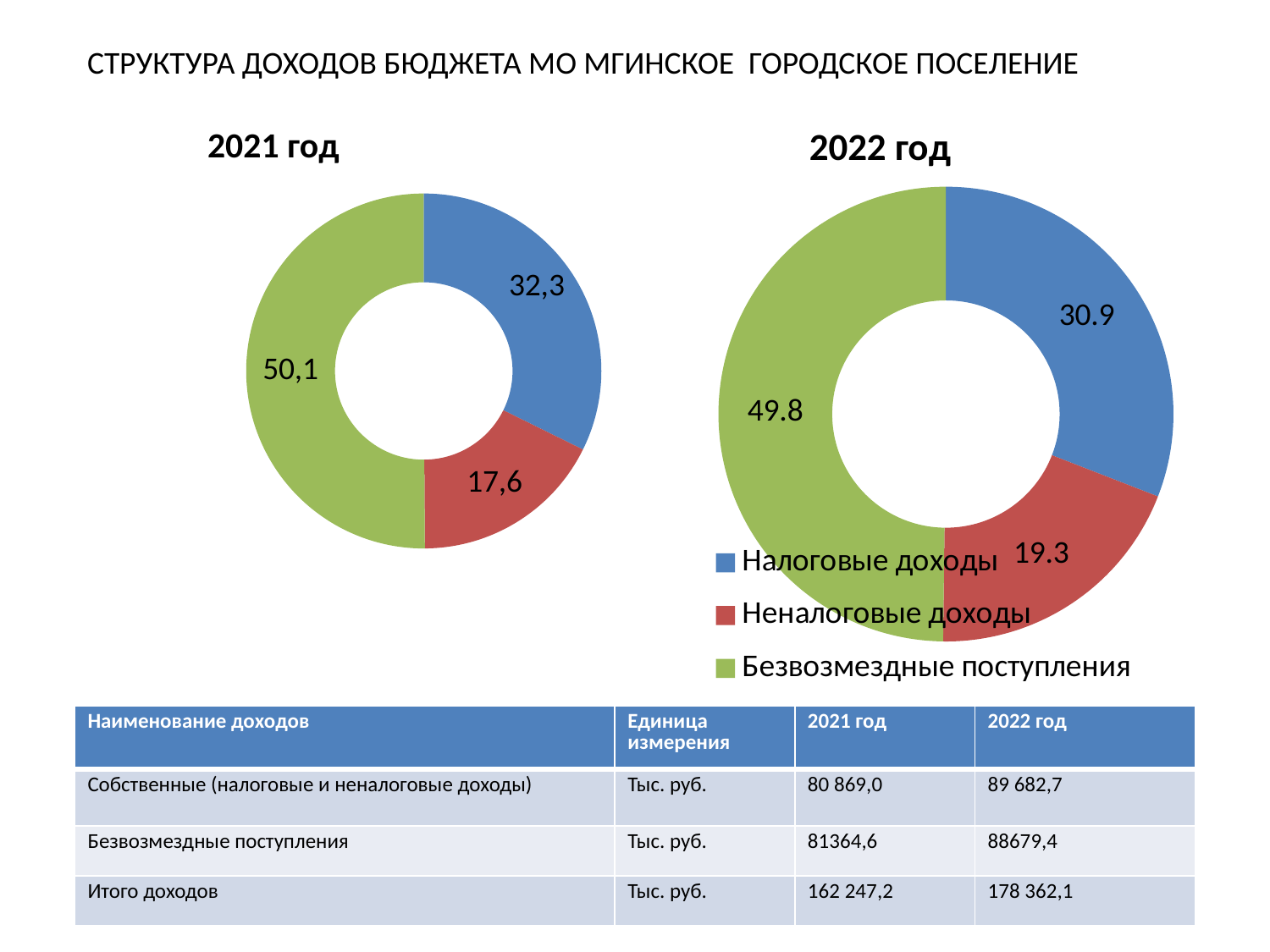
What kind of chart is the "2021 год" chart? Doughnut chart In the "2021 год" chart, what is the value for Налоговые доходы? 32,3 In the "2022 год" chart, which category has the smallest share? Неналоговые доходы How many categories does the "2022 год" chart show? 3 In the "2022 год" chart, what is the value for Неналоговые доходы? 19.3 In the "2022 год" chart, what is the value for Безвозмездные поступления? 49.8 Which colour represents Безвозмездные поступления in the charts? Green How many entries does the legend on the slide list? 3 In the "2021 год" chart, what is the value for Безвозмездные поступления? 50,1 In the "2021 год" chart, which category has the largest share? Безвозмездные поступления In the "2022 год" chart, which is larger: Налоговые доходы or Неналоговые доходы? Налоговые доходы In the "2021 год" chart, what is the difference between the values for Налоговые доходы and Неналоговые доходы? 14,7